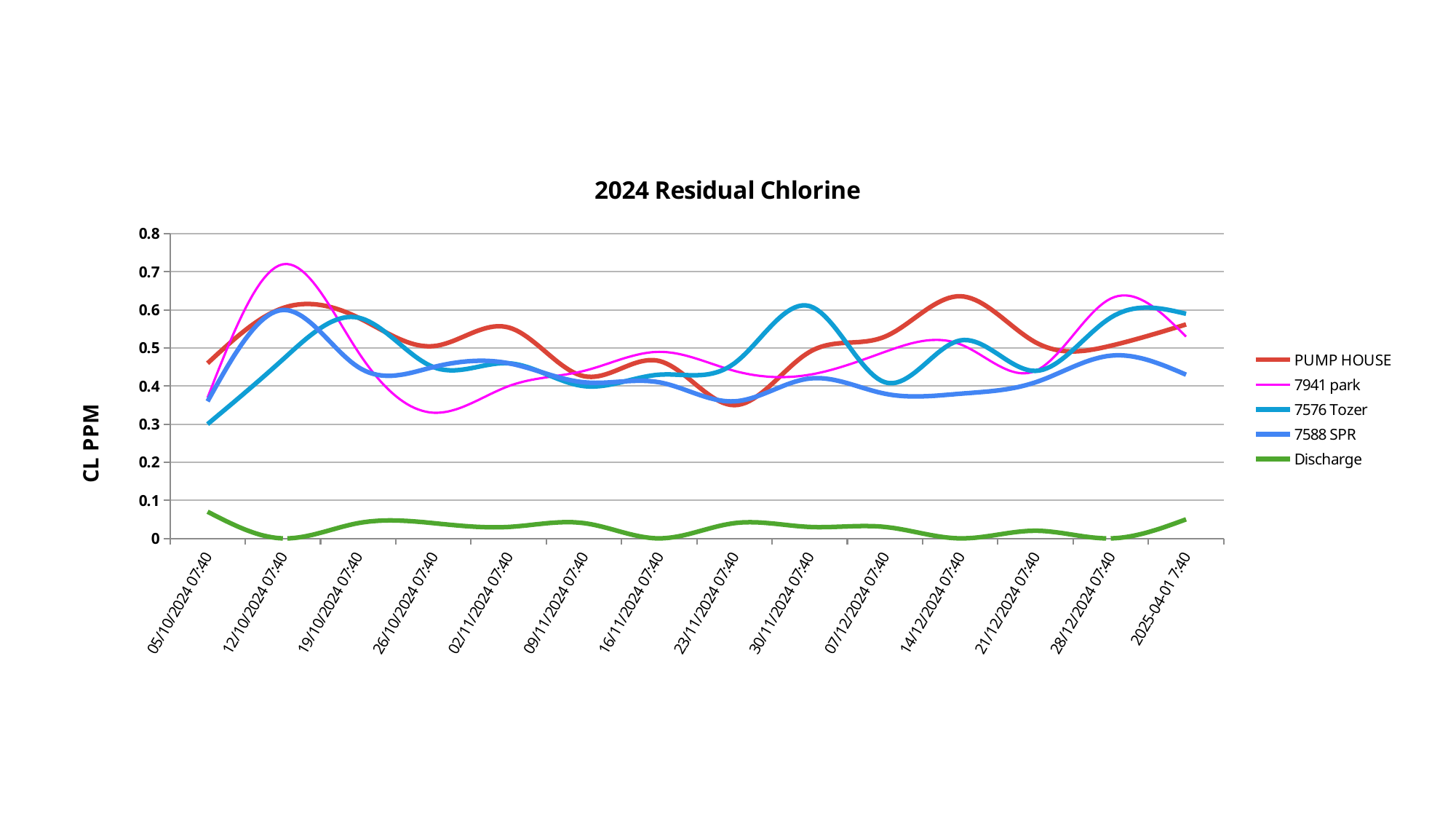
Is the value for 7576 Tozer at 05/10/2024 07:40 greater or less than 0.4? less How many dates are shown along the x axis? 14 At 12/10/2024 07:40, which series has the highest value? 7941 park Which series has the lowest values across the whole chart? Discharge Is the value for PUMP HOUSE at 14/12/2024 07:40 greater or less than 0.6? greater How many series does the legend list? 5 Is the value for Discharge at 05/10/2024 07:40 greater or less than 0.1? less What kind of chart is shown on the slide? line chart What is the title of the chart? 2024 Residual Chlorine At 30/11/2024 07:40, which is larger, the value for 7576 Tozer or the value for 7588 SPR? 7576 Tozer What is the label on the vertical axis? CL PPM